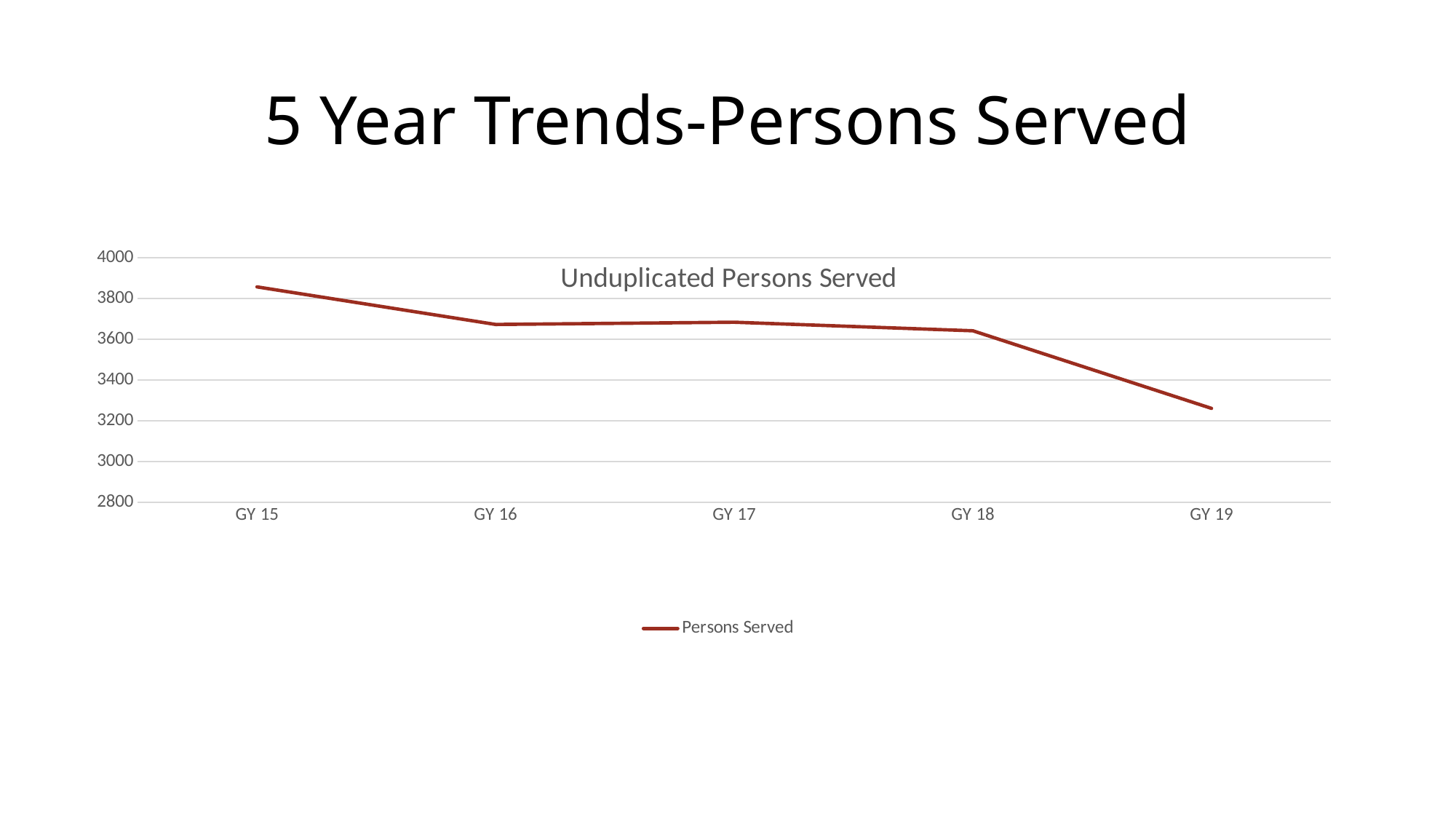
Is the value for GY 16 greater or less than 3600? greater How many series does the legend list? 1 Which is larger, the value for GY 18 or the value for GY 19? GY 18 What is the title of the chart? Unduplicated Persons Served Do the values for Persons Served generally rise or fall from GY 15 to GY 19? fall How many grant years are plotted on the x axis? 5 What is the name of the series shown in the legend? Persons Served Is the value for GY 19 greater or less than 3400? less Is the value for GY 15 greater or less than 3800? greater Which grant year has the highest number of persons served? GY 15 What kind of chart is shown on the slide? line chart Which grant year has the lowest number of persons served? GY 19